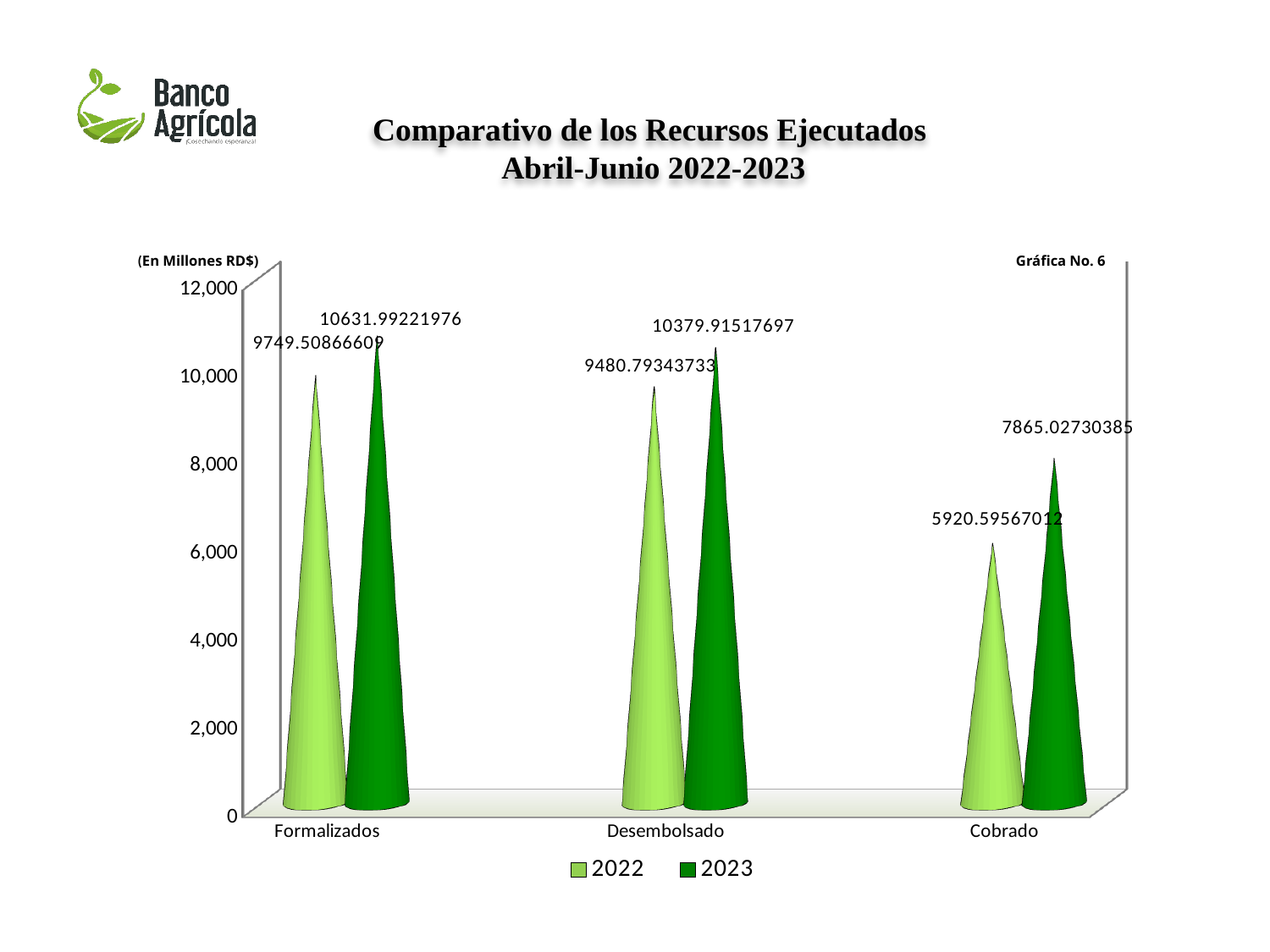
How many categories are shown on the x axis? 3 What is the value for Formalizados in 2022? 9749.50866609 Which category has the highest value for 2023? Formalizados What is the value for Cobrado in 2022? 5920.59567012 What unit is indicated above the vertical axis? En Millones RD$ Which category has the lowest value for 2022? Cobrado What kind of chart is shown on the slide? Bar chart What is the difference between the 2023 and 2022 values for Cobrado? 1944.43163373 What is the value for Desembolsado in 2023? 10379.91517697 Which is larger for Desembolsado, the 2022 value or the 2023 value? 2023 How many series does the legend list? 2 What is the value for Formalizados in 2023? 10631.99221976